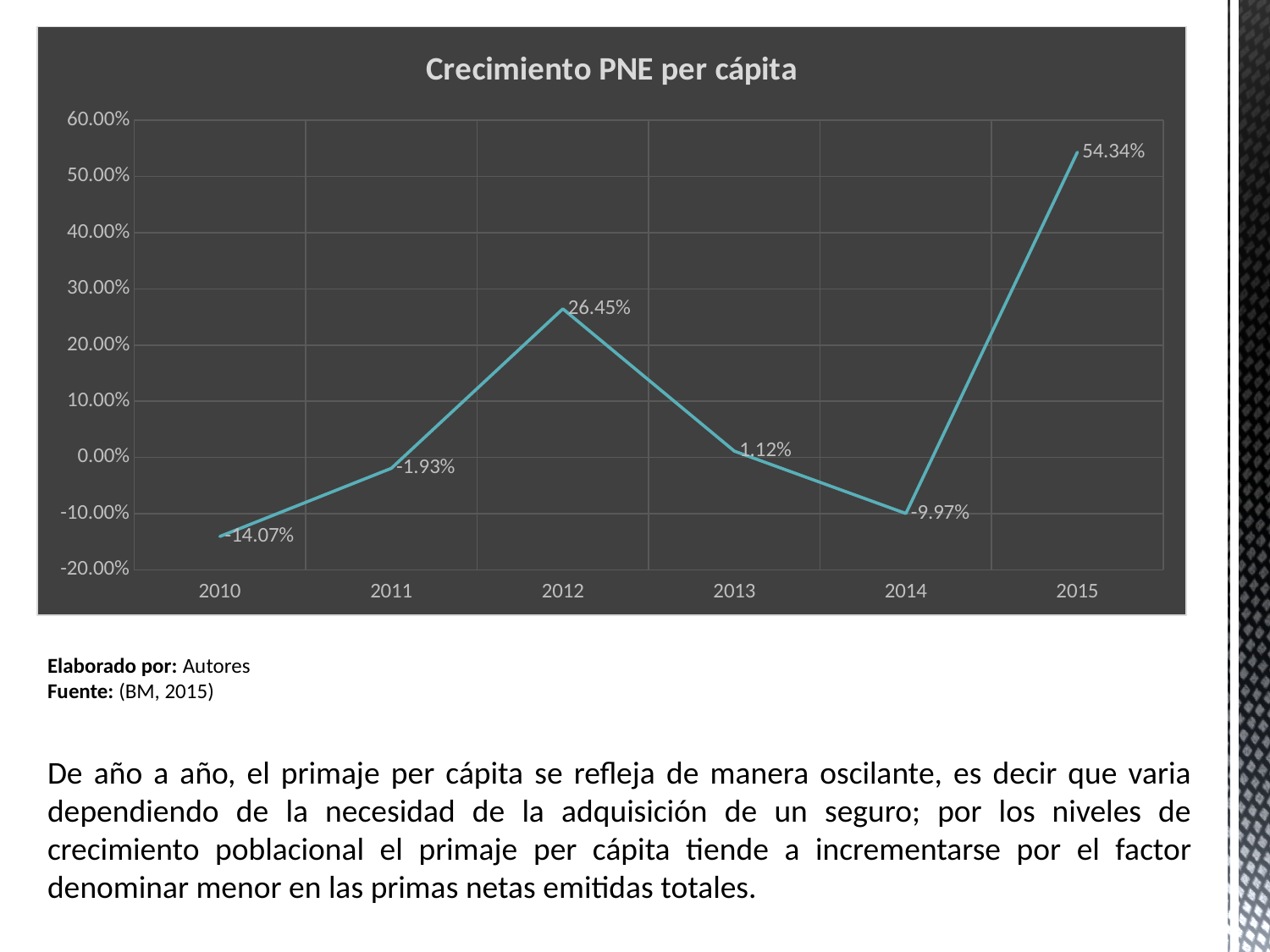
What is the value for 2014? -9.97% Is the value for 2015 greater or less than 50.00%? greater How many years are plotted on the x axis? 6 Which year has the highest value? 2015 What kind of chart is shown on the slide? line chart What is the value for 2015? 54.34% Which is larger, the value for 2011 or the value for 2013? 2013 What is the value for 2010? -14.07% What is the title of the chart? Crecimiento PNE per cápita What is the difference between the values for 2015 and 2012? 27.89% What is the value for 2012? 26.45% Which year has the lowest value? 2010